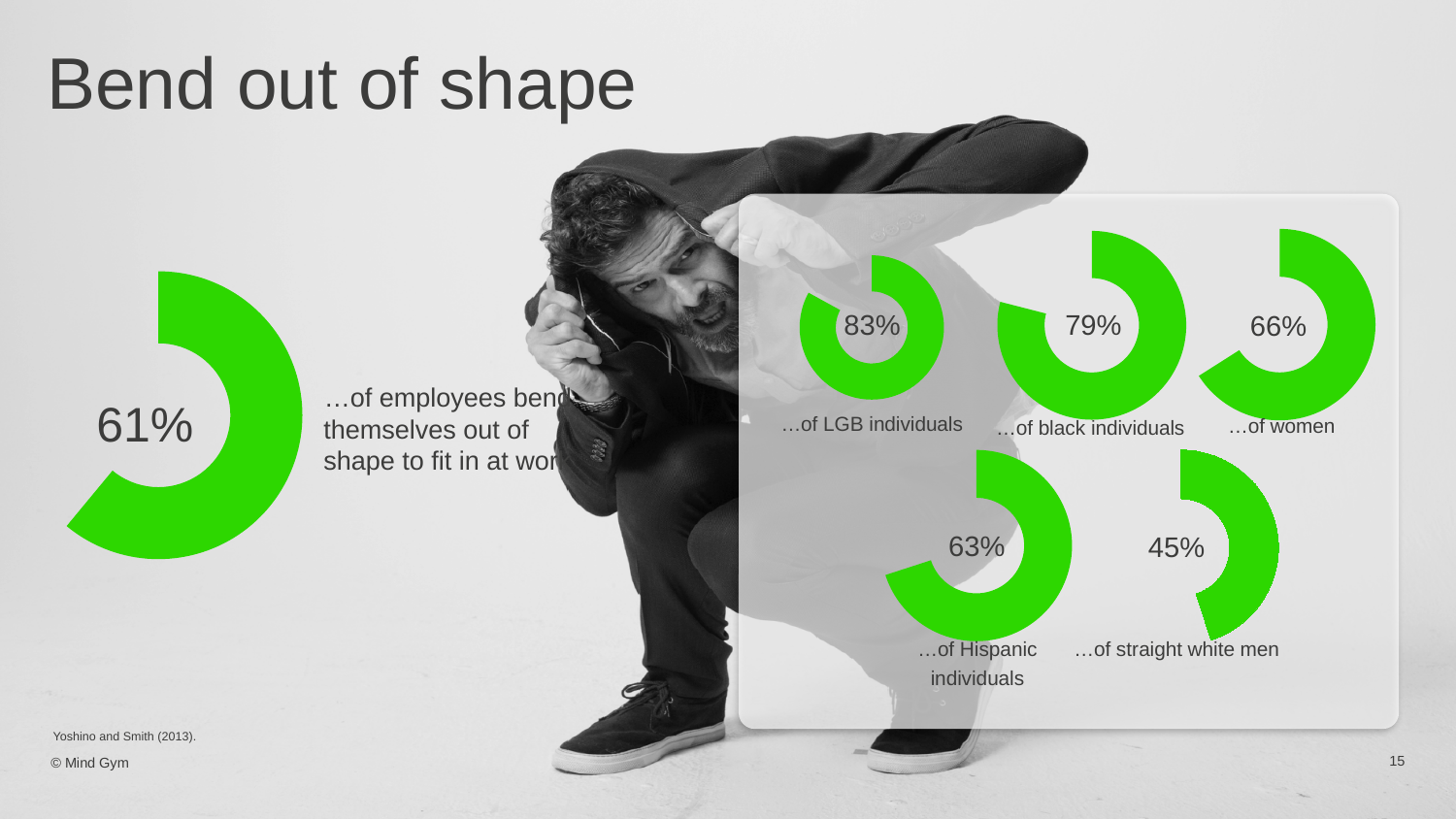
Among the five groups in the panel on the right, which group has the highest percentage? LGB individuals What percentage is shown for Hispanic individuals? 63% What percentage of all employees does the large donut chart on the left show bend themselves out of shape to fit in at work? 61% How many group-specific donut charts are shown in the panel on the right? 5 What percentage is shown for straight white men? 45% Among the five groups in the panel on the right, which group has the lowest percentage? Straight white men What percentage of LGB individuals bend themselves out of shape to fit in at work, according to the slide? 83% What percentage is shown for women? 66% Which is larger: the percentage for women or the percentage for Hispanic individuals? Women What percentage is shown for black individuals? 79% What is the difference between the percentage for LGB individuals and the percentage for straight white men? 38% What type of chart is used to display the percentages on this slide? Donut chart